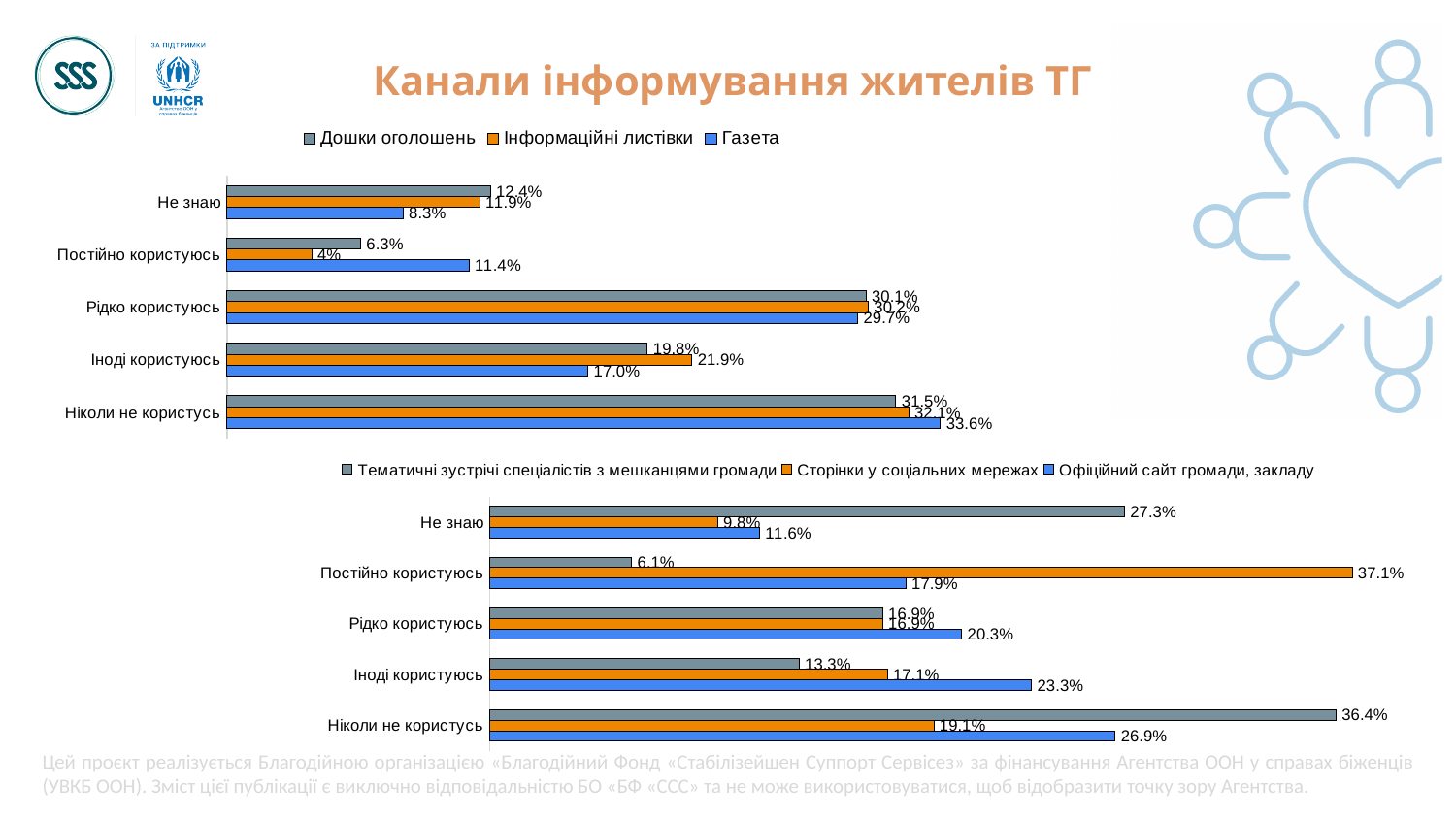
What kind of chart is the top chart? Bar chart In the top chart, what is the value for Дошки оголошень in the Не знаю category? 12.4% In the top chart, which category has the lowest value for Інформаційні листівки? Постійно користуюсь In the bottom chart, which category has the highest value for Тематичні зустрічі спеціалістів з мешканцями громади? Ніколи не користусь How many series does the legend of the bottom chart list? 3 How many categories are shown in the top chart? 5 In the bottom chart, what is the difference between Сторінки у соціальних мережах and Тематичні зустрічі спеціалістів з мешканцями громади in the Постійно користуюсь category? 31.0 percentage points In the bottom chart, what is the value for Офіційний сайт громади, закладу in the Іноді користуюсь category? 23.3% In the bottom chart, what is the value for Сторінки у соціальних мережах in the Постійно користуюсь category? 37.1% In the top chart, which is larger in the Іноді користуюсь category: Інформаційні листівки or Газета? Інформаційні листівки In the top chart, what is the difference between Газета and Дошки оголошень in the Не знаю category? 4.1 percentage points In the top chart, what is the value for Газета in the Постійно користуюсь category? 11.4%